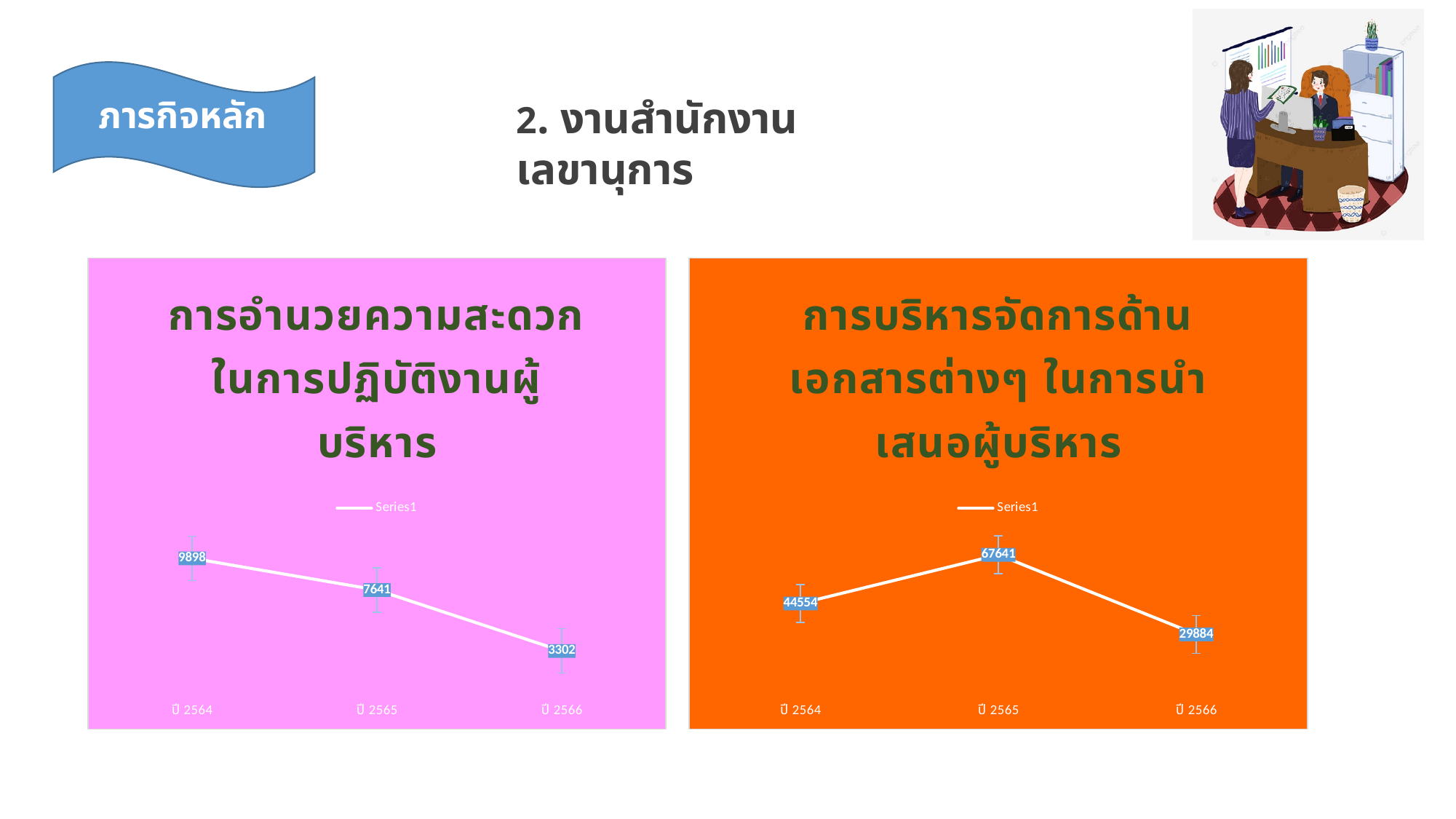
In the right chart, which year has the lowest value? ปี 2566 In the right chart, what is the difference between the values for ปี 2565 and ปี 2564? 23087 In the right chart, which year has the highest value? ปี 2565 In the left chart, do the values rise or fall from ปี 2564 to ปี 2566? fall What type of chart is the left chart? line chart In the left chart, what is the difference between the values for ปี 2564 and ปี 2566? 6596 In the left chart (การอำนวยความสะดวกในการปฏิบัติงานผู้บริหาร), what is the value for ปี 2564? 9898 In the right chart (การบริหารจัดการด้านเอกสารต่างๆ ในการนำเสนอผู้บริหาร), what is the value for ปี 2565? 67641 In the left chart (การอำนวยความสะดวกในการปฏิบัติงานผู้บริหาร), what is the value for ปี 2566? 3302 How many data points are plotted in the right chart? 3 In the left chart, which year has the lowest value? ปี 2566 In the right chart (การบริหารจัดการด้านเอกสารต่างๆ ในการนำเสนอผู้บริหาร), what is the value for ปี 2566? 29884